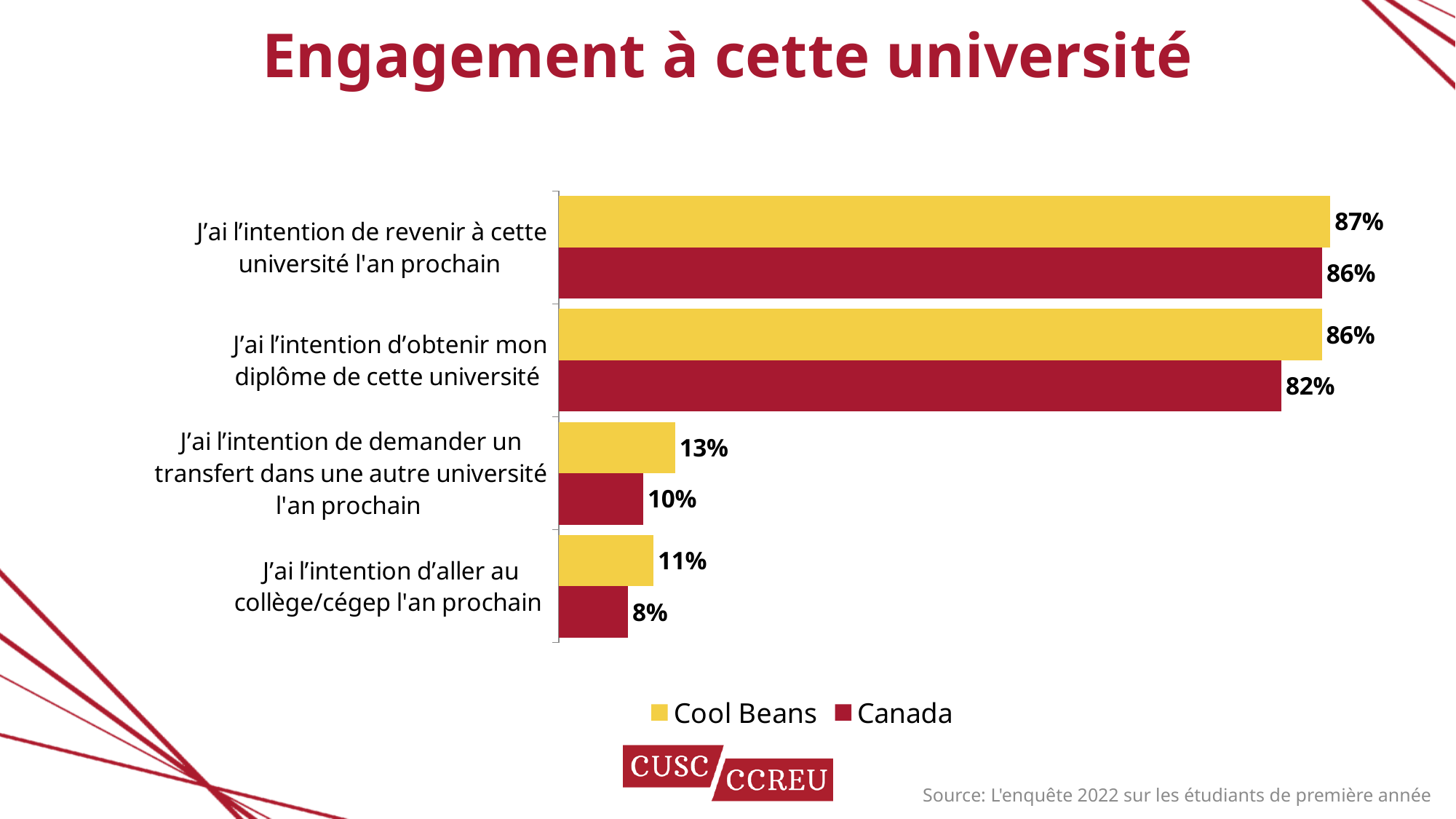
What is the difference between the Cool Beans and Canada values for "J'ai l'intention d'obtenir mon diplôme de cette université"? 4% How many series does the legend list? 2 What is the Canada value for "J'ai l'intention d'obtenir mon diplôme de cette université"? 82% For "J'ai l'intention de demander un transfert dans une autre université l'an prochain", which is larger: Cool Beans or Canada? Cool Beans How many categories are shown on the chart? 4 What is the Canada value for "J'ai l'intention d'aller au collège/cégep l'an prochain"? 8% Which category has the highest Cool Beans value? J'ai l'intention de revenir à cette université l'an prochain What is the Cool Beans value for "J'ai l'intention de revenir à cette université l'an prochain"? 87% What is the Cool Beans value for "J'ai l'intention de demander un transfert dans une autre université l'an prochain"? 13% What kind of chart is shown on the slide? Bar chart Which category has the lowest Canada value? J'ai l'intention d'aller au collège/cégep l'an prochain What is the title of the chart? Engagement à cette université